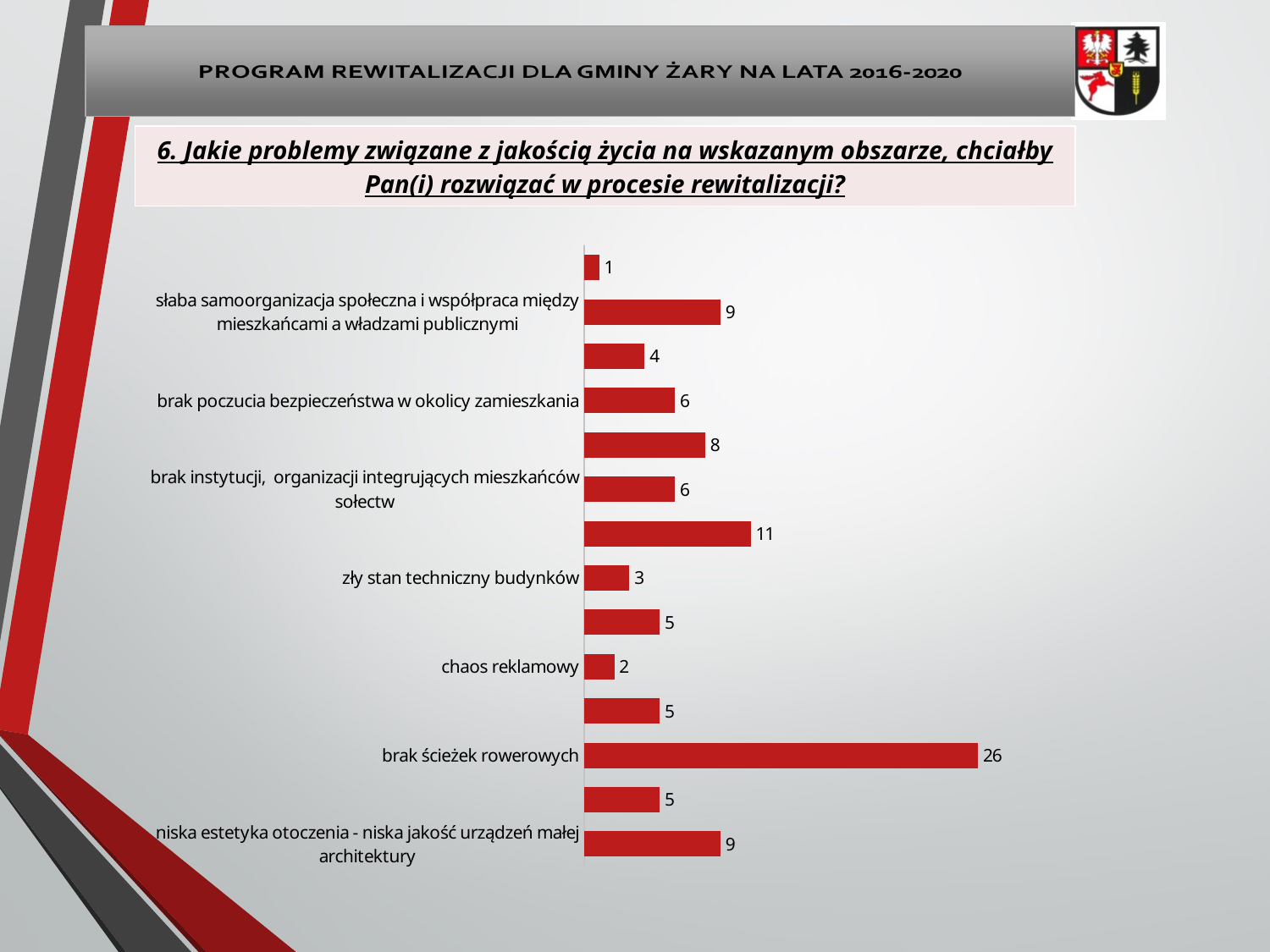
What kind of chart is shown on the slide? bar chart What is the difference between the values for "słaba samoorganizacja społeczna i współpraca między mieszkańcami a władzami publicznymi" and "zły stan techniczny budynków"? 6 What is the value for "brak ścieżek rowerowych"? 26 Which category has the highest value in the chart? brak ścieżek rowerowych What is the value for "brak poczucia bezpieczeństwa w okolicy zamieszkania"? 6 Which is larger: the value for "brak poczucia bezpieczeństwa w okolicy zamieszkania" or for "zły stan techniczny budynków"? brak poczucia bezpieczeństwa w okolicy zamieszkania How many bars are plotted in the chart? 14 What is the difference between the values for "brak ścieżek rowerowych" and "chaos reklamowy"? 24 What is the value for "zły stan techniczny budynków"? 3 What is the value for "chaos reklamowy"? 2 What is the value for "niska estetyka otoczenia - niska jakość urządzeń małej architektury"? 9 What is the value for "słaba samoorganizacja społeczna i współpraca między mieszkańcami a władzami publicznymi"? 9